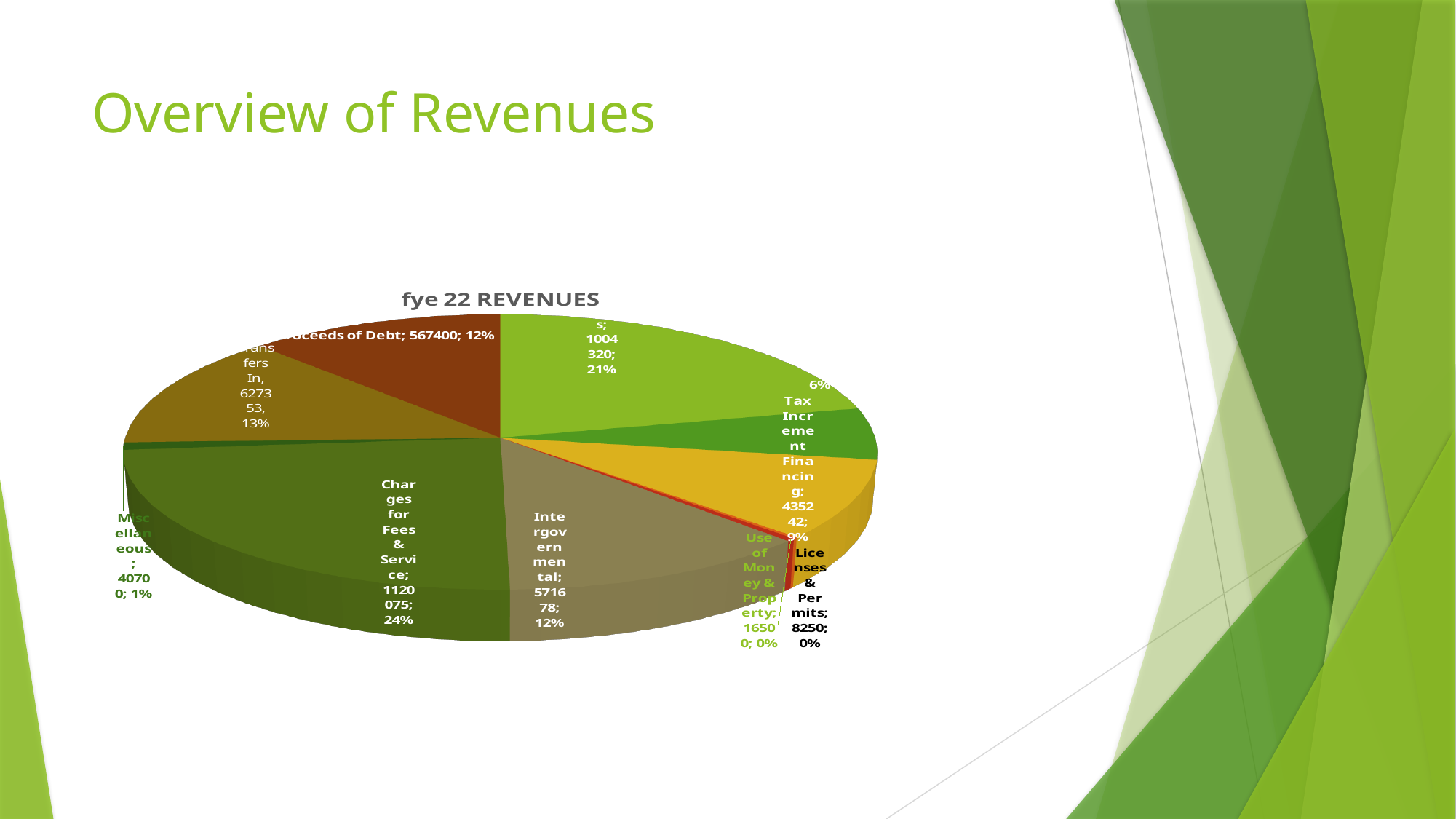
Which is larger, Transfers In or Proceeds of Debt? Transfers In Which category has the largest share of the pie? Charges for Fees & Service What is the value for Miscellaneous? 40700 What is the title of the chart? fye 22 REVENUES Which has the smaller value, Licenses & Permits or Use of Money & Property? Licenses & Permits What is the value for Proceeds of Debt? 567400 What is the difference between the values for Charges for Fees & Service and Intergovernmental? 548397 What share of the pie does Charges for Fees & Service represent? 24% What share of the pie does Tax Increment Financing represent? 9% What is the value for Charges for Fees & Service? 1120075 What is the value for Intergovernmental? 571678 What type of chart is shown on the slide? Pie chart